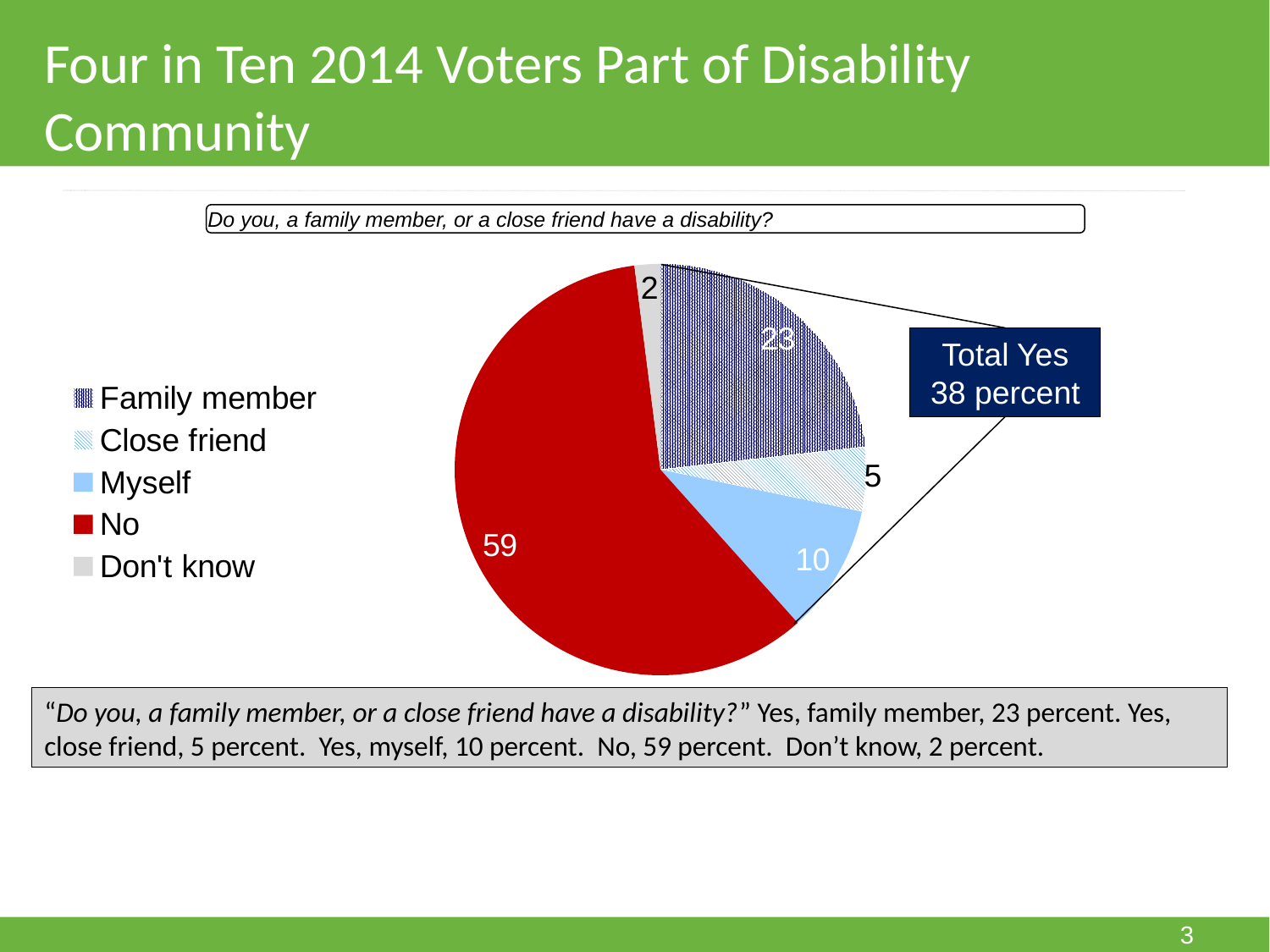
What is the difference between the No slice and the Family member slice? 36 Which is larger, the Myself slice or the Close friend slice? Myself Which category has the smallest slice? Don't know What is the value for the Myself slice? 10 How many categories does the legend list? 5 What kind of chart is shown on the slide? pie chart What is the value for the Don't know slice? 2 What is the value for the No slice? 59 What total does the callout box next to the pie report for all Yes responses? 38 percent Which category has the largest slice? No What is the value for the Close friend slice? 5 What is the value for the Family member slice? 23